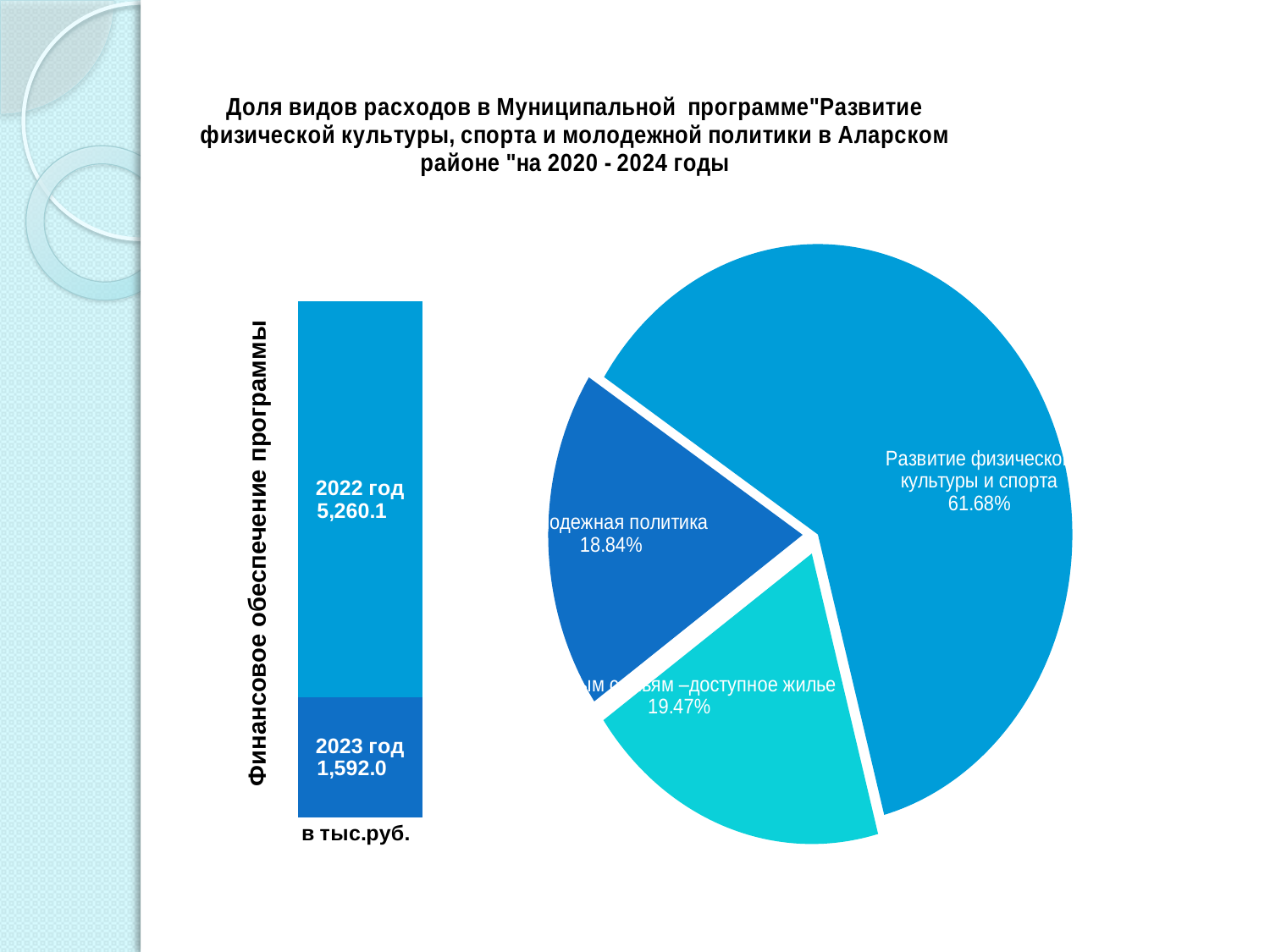
On the left bar chart, what unit is stated below the bar? в тыс.руб. On the pie chart, which slice is the largest? Развитие физической культуры и спорта On the left bar chart, what is the value for 2023 год? 1,592.0 What kind of chart is shown on the right of the slide? Pie chart How many slices does the pie chart have? 3 On the pie chart, what share does the slice labelled 19.47% represent compared with the slice labelled 18.84% — which is larger? 19.47% On the left bar chart, what is the value for 2022 год? 5,260.1 On the left bar chart, what is the difference between the 2022 год and 2023 год values? 3,668.1 What kind of chart is shown on the left of the slide? Bar chart On the pie chart, what share does Развитие физической культуры и спорта have? 61.68% On the left bar chart, which year has the larger value, 2022 год or 2023 год? 2022 год On the left bar chart, what is the total of the stacked bar (2022 год plus 2023 год)? 6,852.1